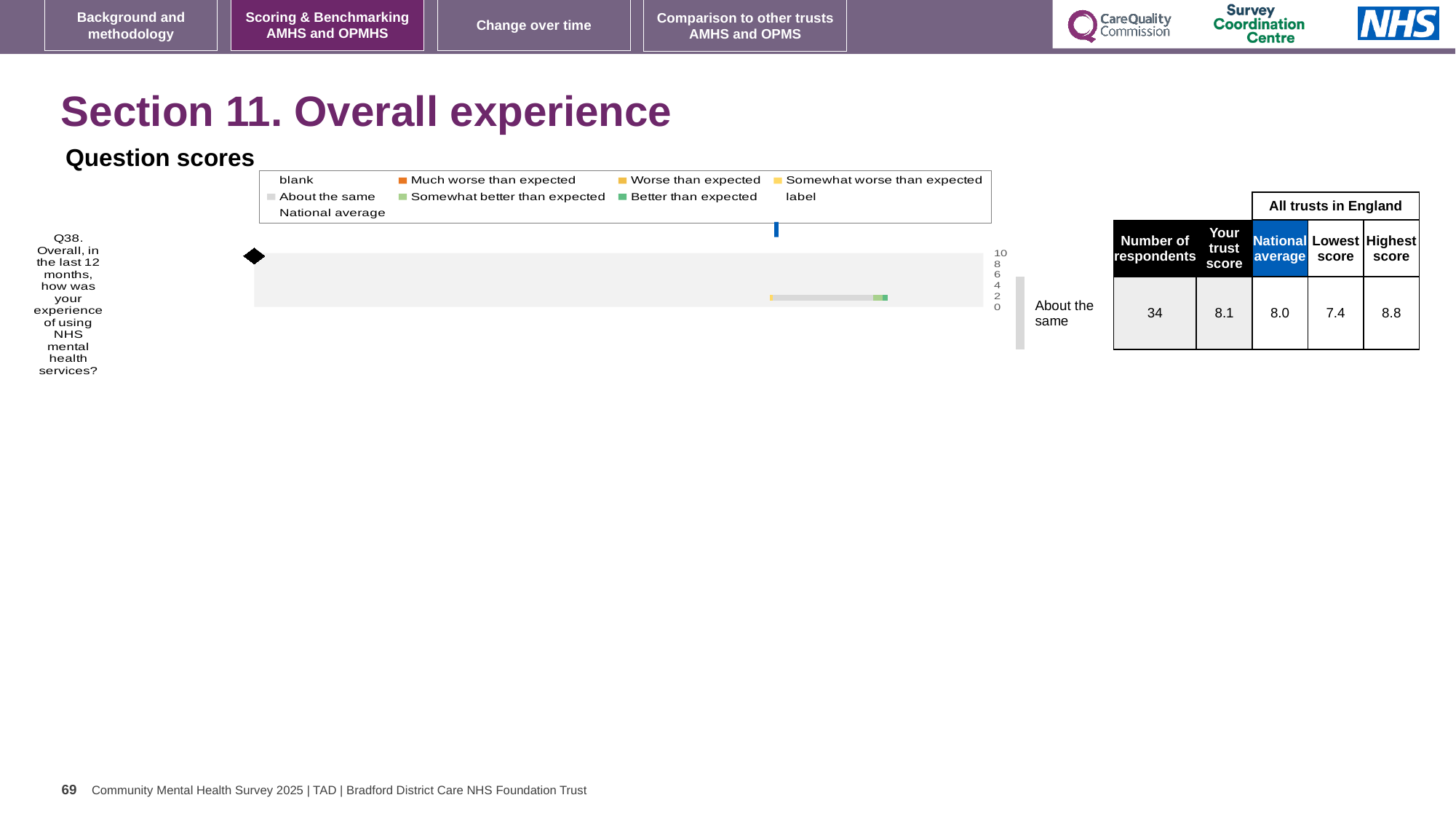
What is the lowest score among all trusts in England for Q38? 7.4 What is the trust's score for Q38? 8.1 Which legend entry in the Question scores chart is shown in orange? Much worse than expected Which is larger for Q38: the trust's score or the national average? the trust's score What is the difference between the highest and lowest scores for Q38 across all trusts in England? 1.4 How many respondents answered Q38? 34 Which question is plotted in the Question scores chart? Q38. Overall, in the last 12 months, how was your experience of using NHS mental health services? What is the highest score among all trusts in England for Q38? 8.8 What benchmark category is shown for Q38 next to the chart? About the same What kind of chart is shown under 'Question scores'? bar chart How many survey questions are plotted in the Question scores chart? 1 What is the national average score for Q38? 8.0